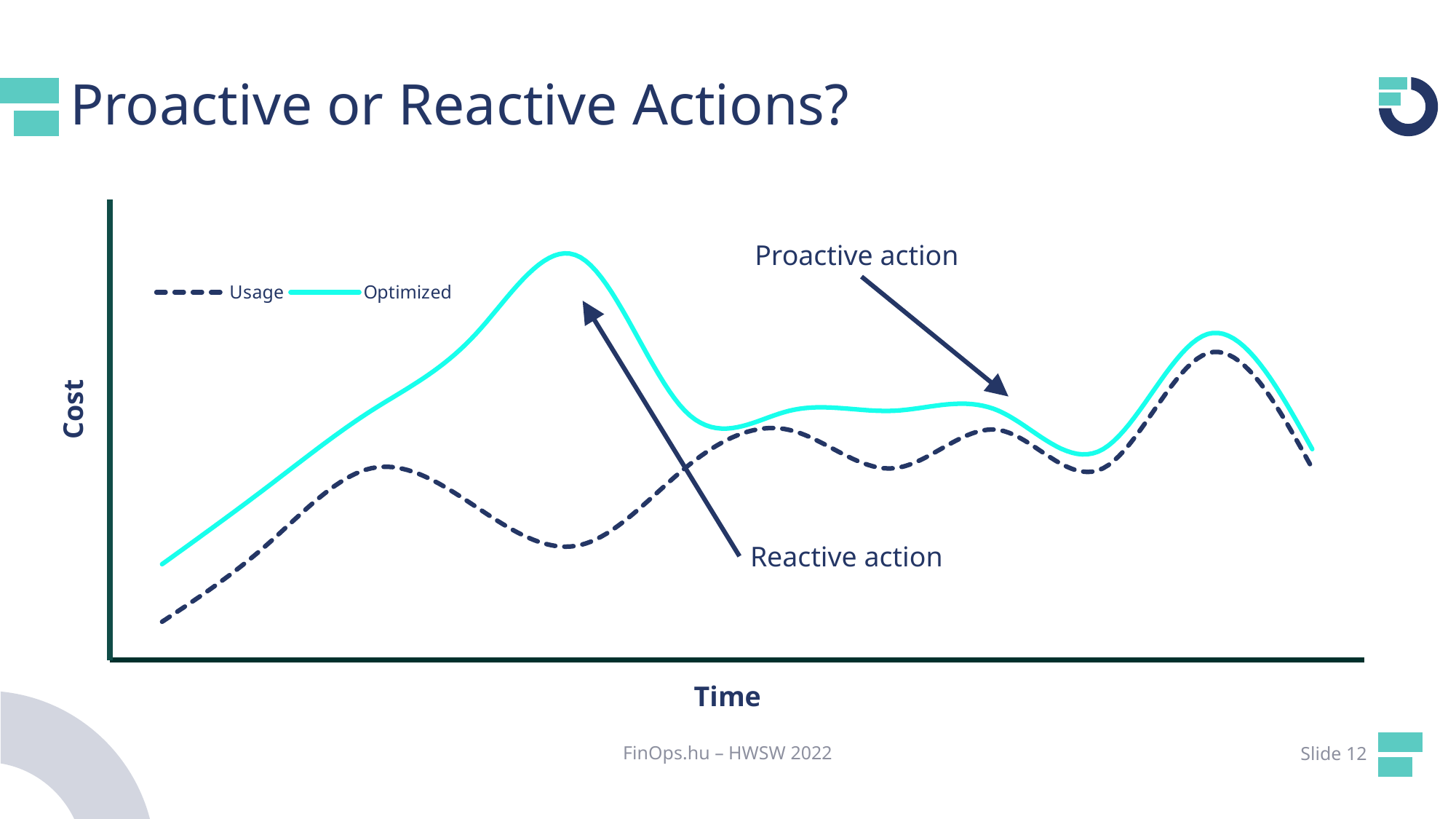
Does the Usage line rise or fall at the far right end of the chart? Fall Which series has the lowest point on the chart? Usage Which series reaches the highest point on the chart? Optimized Does the Optimized line rise or fall from the start of the chart to its first peak? Rise At the left edge of the chart, which series is higher, Usage or Optimized? Optimized Which series is drawn as a dashed line? Usage What are the two series named in the chart's legend? Usage and Optimized What kind of chart is shown on the slide? Line chart How many series does the chart's legend list? 2